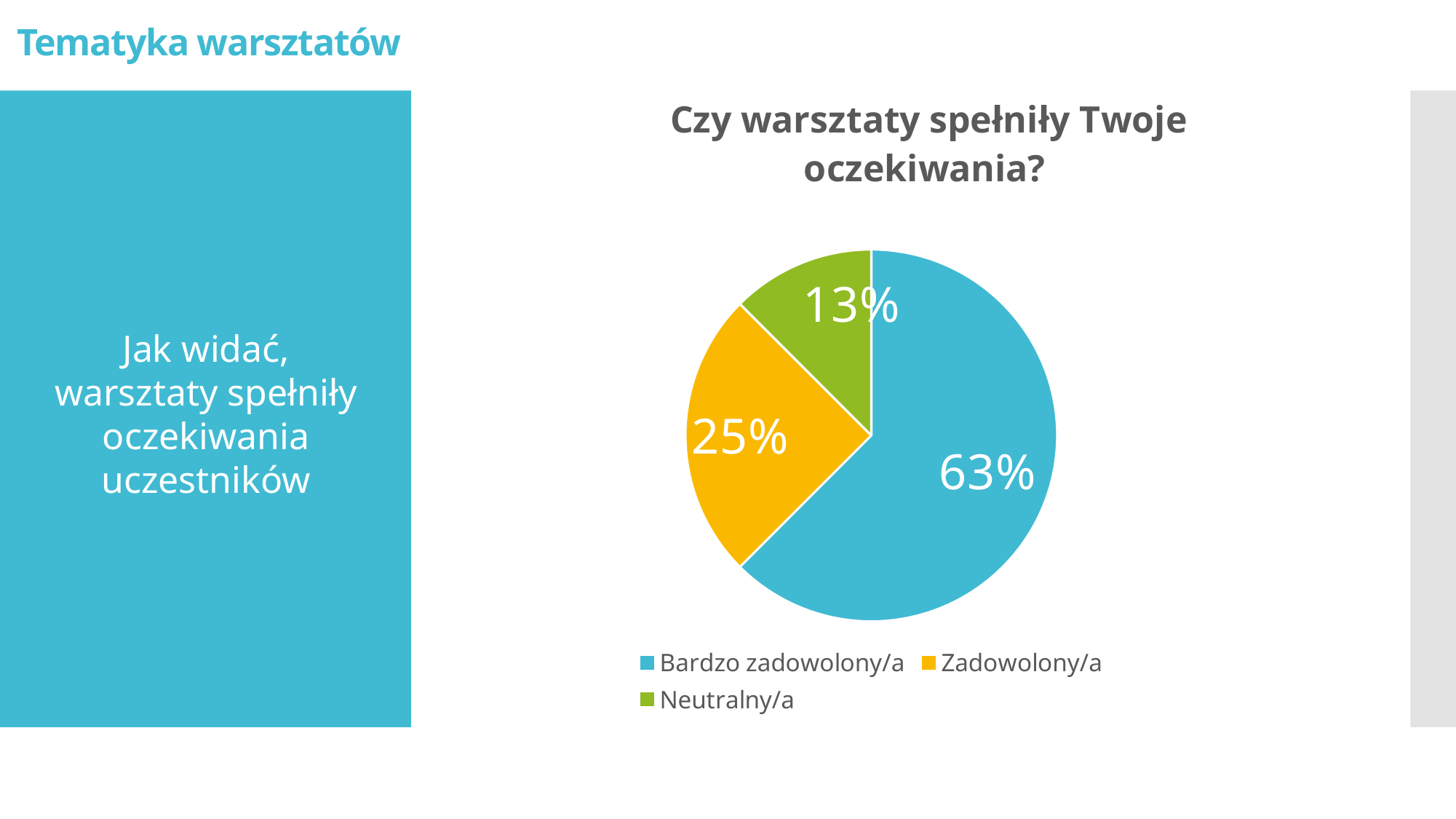
What share of the pie does "Bardzo zadowolony/a" have? 63% Which is larger: the share for "Zadowolony/a" or the share for "Neutralny/a"? Zadowolony/a What kind of chart is shown on the slide? pie chart Which category has the largest slice of the pie? Bardzo zadowolony/a What is the title of the chart? Czy warsztaty spełniły Twoje oczekiwania? What share of the pie does "Neutralny/a" have? 13% How many categories does the pie chart show? 3 Which category has the smallest slice of the pie? Neutralny/a What share of the pie does "Zadowolony/a" have? 25% What colour is the slice for "Neutralny/a"? green What is the difference in percentage points between "Bardzo zadowolony/a" and "Zadowolony/a"? 38 What is the difference in percentage points between "Zadowolony/a" and "Neutralny/a"? 12